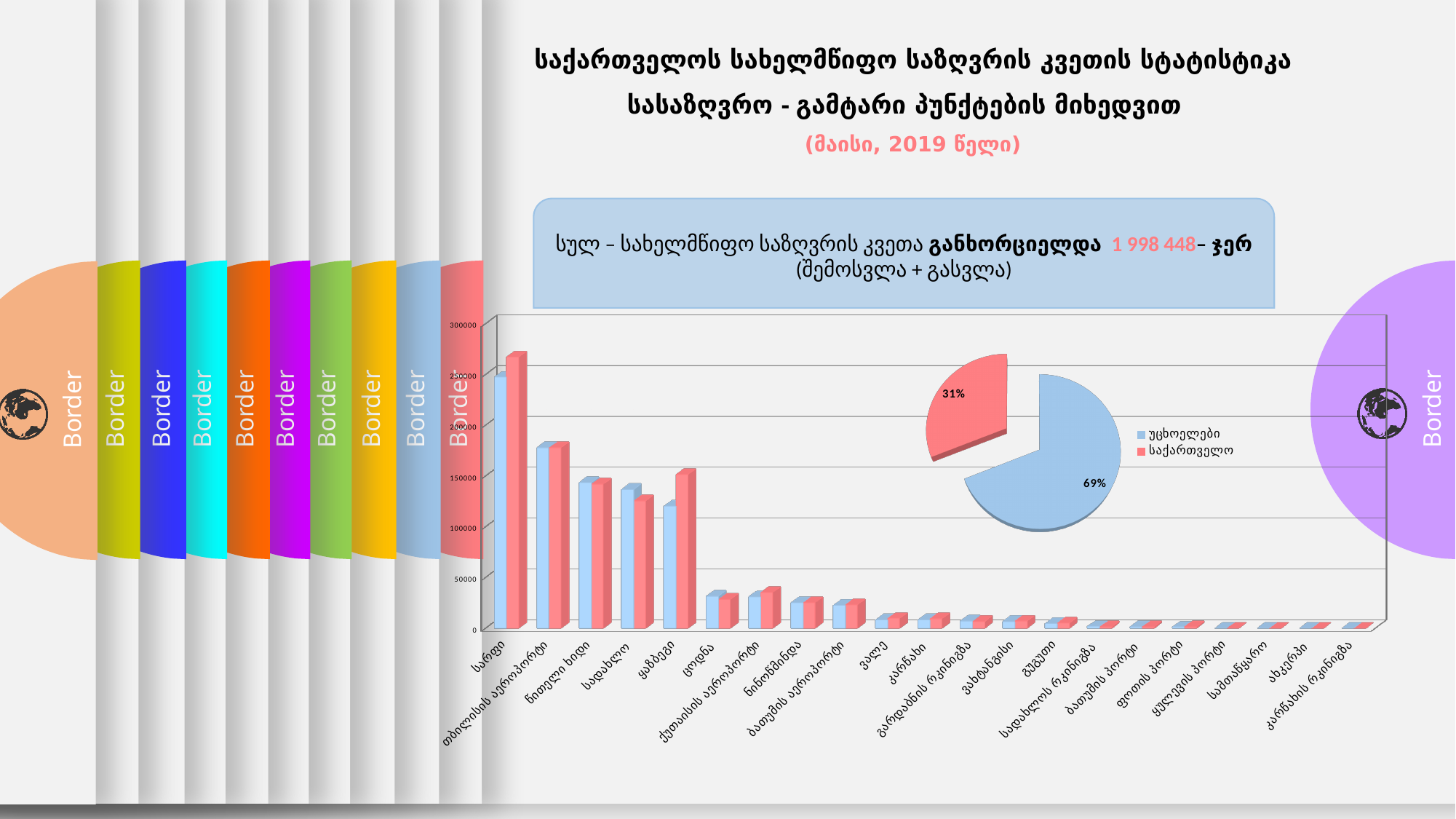
In the bar chart, is the red bar for სარფი greater or less than 250000? greater In the bar chart, is the blue bar for ცოდნა greater or less than 50000? less In the pie chart, which slice is larger, უცხოელები or საქართველო? უცხოელები What kind of chart is the large chart at the bottom of the slide? bar chart What kind of chart is the smaller chart on the right side of the slide? pie chart In the bar chart, is the blue bar for თბილისის აეროპორტი greater or less than 200000? less In the bar chart, do the values generally rise or fall moving from left to right along the x axis? fall In the bar chart, which category has the highest values? სარფი In the pie chart, what share is labelled for the blue slice? 69% In the pie chart, what share is labelled for the red slice? 31% How many series does the legend next to the pie chart list? 2 How many categories are shown on the x axis of the bar chart? 21